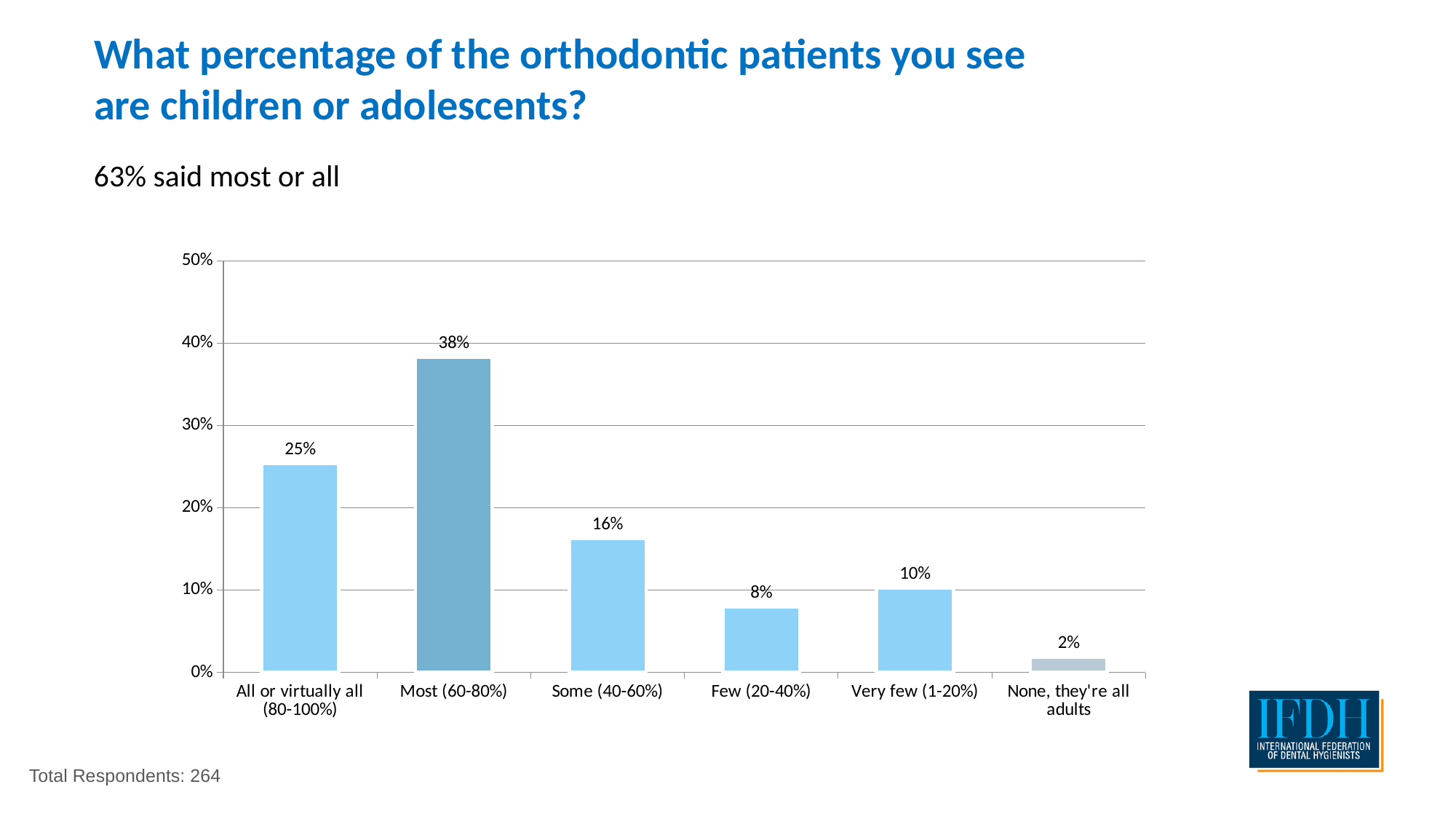
What is the value for Most (60-80%)? 38% What is the total number of respondents stated on the slide? 264 Which category has the lowest value? None, they're all adults Is the value for Some (40-60%) greater or less than 20%? less What is the value for All or virtually all (80-100%)? 25% What is the value for None, they're all adults? 2% What is the difference between the values for Most (60-80%) and All or virtually all (80-100%)? 13% How many categories are shown on the x axis? 6 What kind of chart is shown on the slide? bar chart Which category has the highest value? Most (60-80%) What is the value for Few (20-40%)? 8% Which is larger, the value for Some (40-60%) or the value for Very few (1-20%)? Some (40-60%)